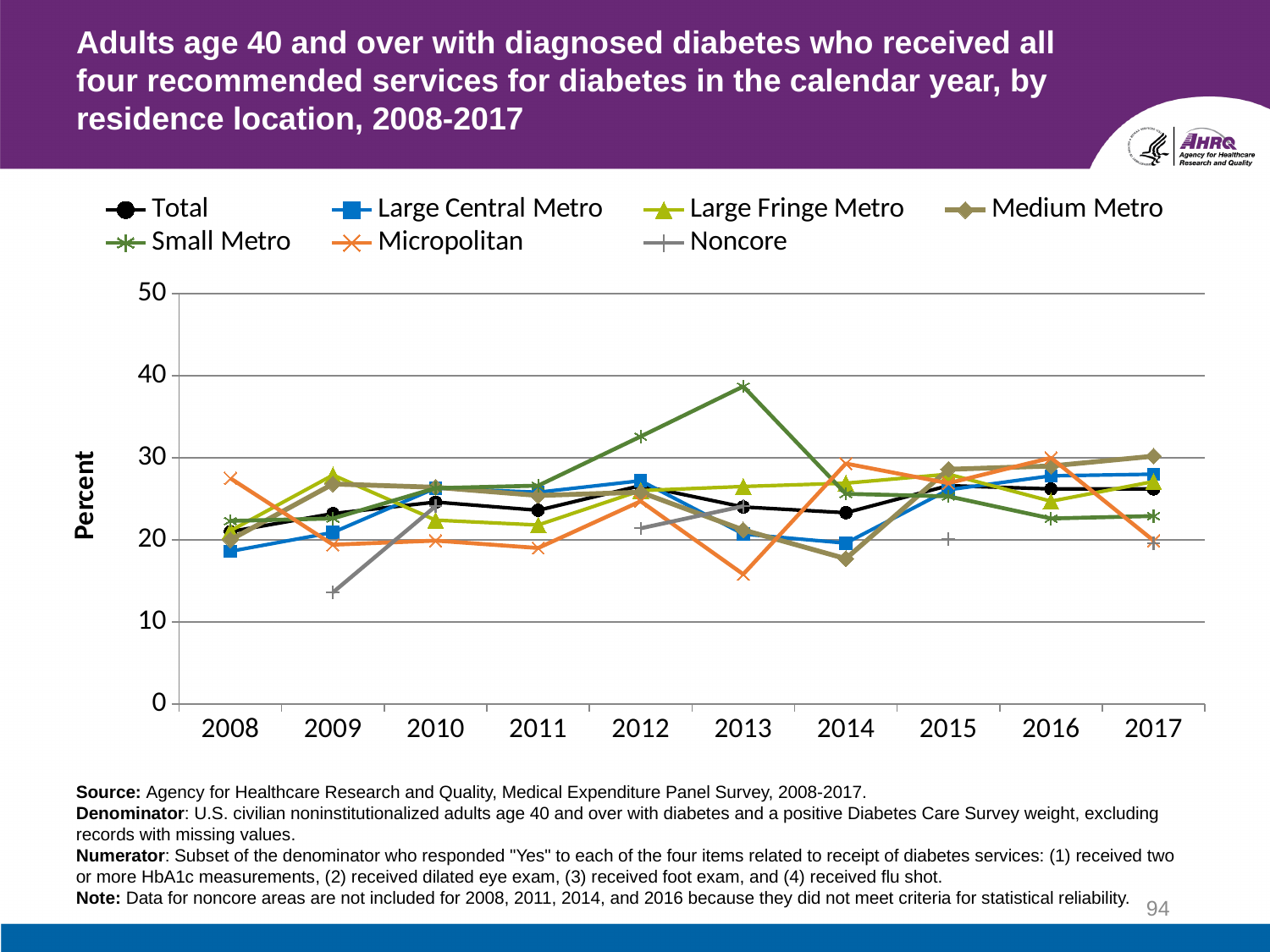
Does the Small Metro line rise or fall from 2013 to 2014? fall Is the value for Small Metro in 2013 greater or less than 30? greater Which series has the lowest value in 2009? Noncore Is the value for Noncore in 2009 greater or less than 20? less Which series has the lowest value in 2013? Micropolitan In 2008, which is higher: Micropolitan or Large Central Metro? Micropolitan Is the value for Micropolitan in 2008 greater or less than 20? greater How many years are plotted along the x axis? 10 What kind of chart is shown on the slide? line chart What is the label on the y axis? Percent Which series has the highest value in 2013? Small Metro How many series does the legend list? 7